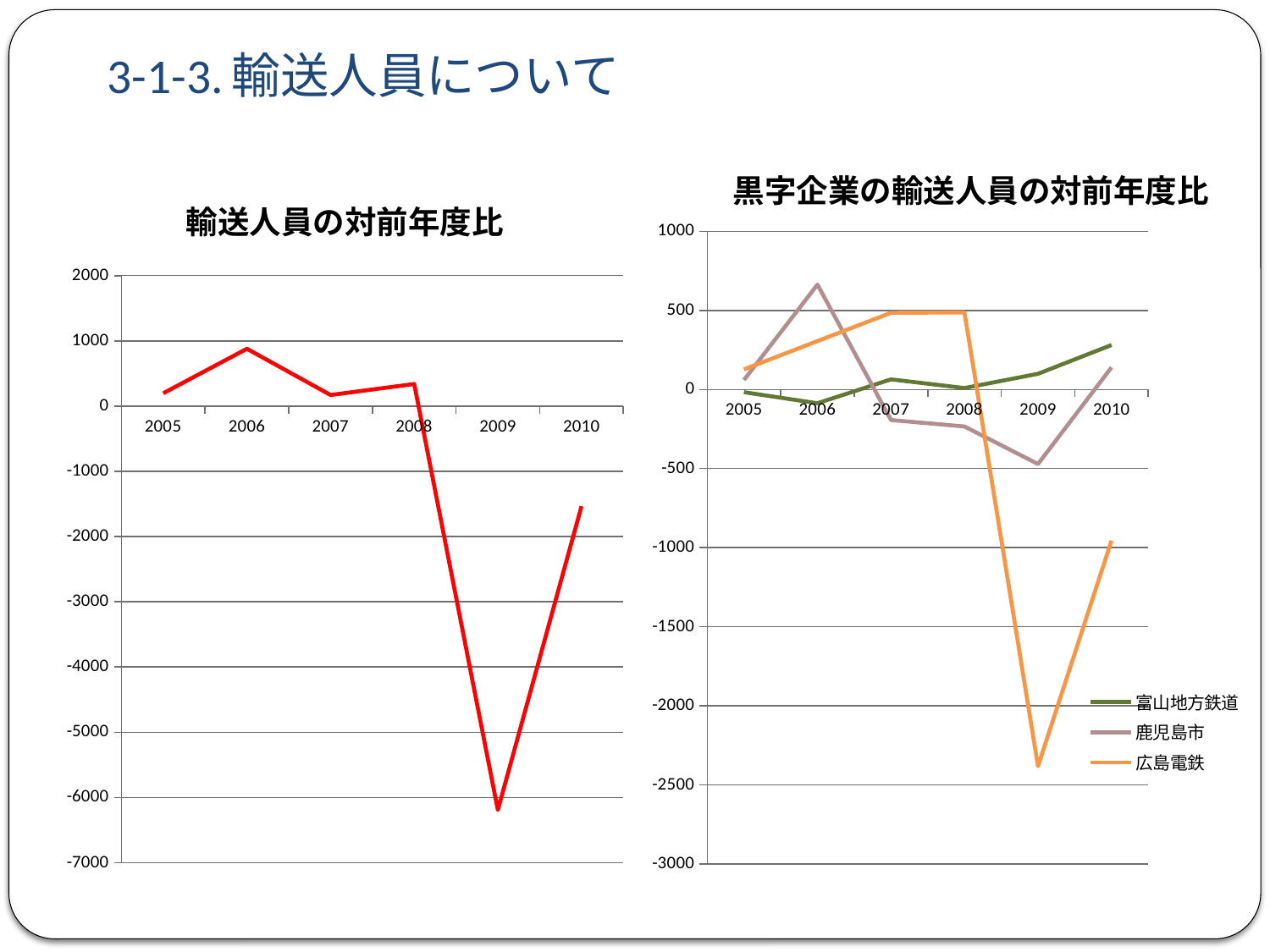
In the left chart 輸送人員の対前年度比, which year has the highest value? 2006 What kind of chart is the left chart titled 輸送人員の対前年度比? line chart In the right chart 黒字企業の輸送人員の対前年度比, which year has the lowest value for 広島電鉄? 2009 In the left chart 輸送人員の対前年度比, which year has the lowest value? 2009 In the left chart 輸送人員の対前年度比, does the value rise or fall from 2008 to 2009? fall How many series does the legend of the right chart 黒字企業の輸送人員の対前年度比 list? 3 In the left chart 輸送人員の対前年度比, is the value for 2009 greater or less than -6000? less In the right chart 黒字企業の輸送人員の対前年度比, is the value for 広島電鉄 in 2009 greater or less than -2000? less In the left chart 輸送人員の対前年度比, is the value for 2010 greater or less than -2000? greater In the right chart 黒字企業の輸送人員の対前年度比, which year has the highest value for 鹿児島市? 2006 In the left chart 輸送人員の対前年度比, how many years are plotted on the x axis? 6 In the right chart 黒字企業の輸送人員の対前年度比, which series is drawn in orange? 広島電鉄